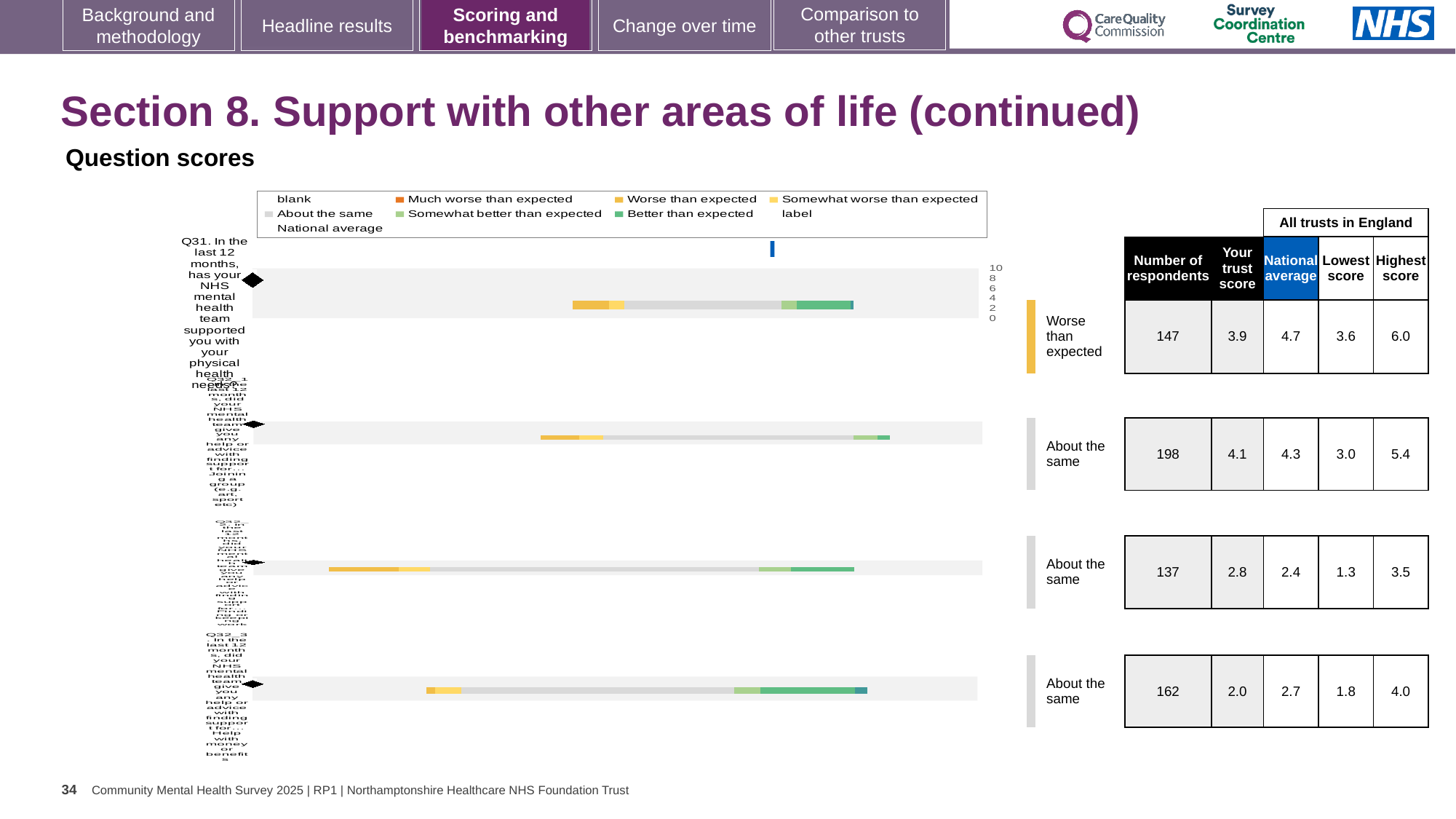
What kind of chart is shown on the slide? Bar chart For Q31 (the top bar), which is larger: the trust score or the national average? National average In the chart legend, what colour represents 'Better than expected'? Green What is the trust score for Q31 (the top bar)? 3.9 What is the trust score for the bottom bar (Q32_3)? 2.0 What is the number of respondents for Q31 (the top bar)? 147 What is the difference between the highest score and the lowest score for Q31 (the top bar)? 2.4 Which question row has the highest number of respondents? Q32_1 (second bar from the top), 198 What is the national average for Q31 (the top bar)? 4.7 Which benchmark category is Q31 (the top bar) assigned to? Worse than expected How many question bars are plotted in the chart? 4 In the chart legend, what colour represents 'About the same'? Grey